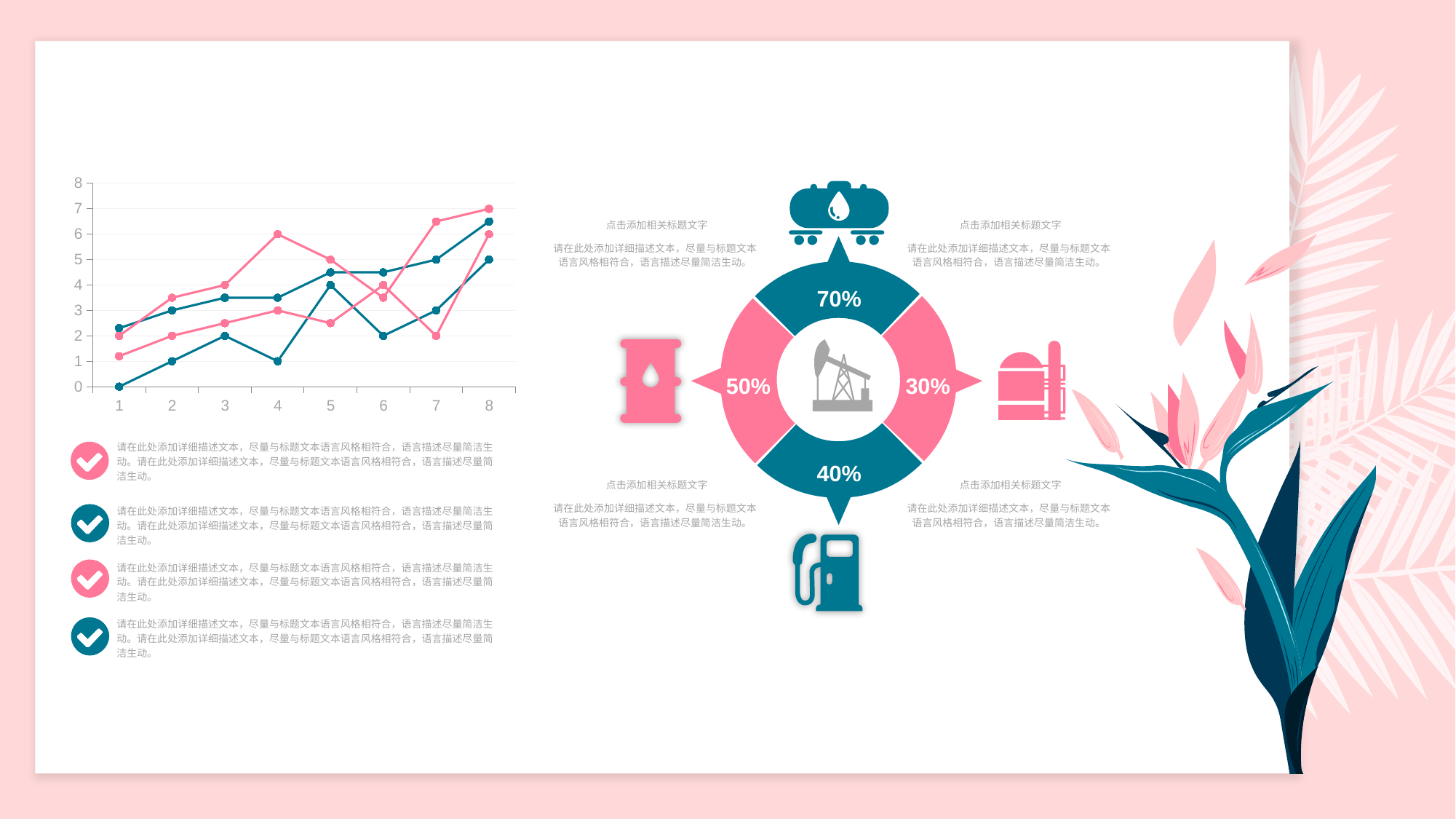
In the ring diagram on the right, what is the difference between the top segment (70%) and the right segment (30%)? 40% In the line chart on the left, what is the lowest value plotted at x = 1? 0 In the ring diagram on the right, which percentage is the largest? 70% What kind of chart is shown on the left side of the slide? line chart In the line chart on the left, how many lines are plotted? 4 In the line chart on the left, at which x position does the highest plotted value occur? 8 In the line chart on the left, what is the highest value shown on the y axis? 8 In the line chart on the left, how many points are labelled along the x axis? 8 In the line chart on the left, is the lowest value plotted at x = 8 greater or less than 4? greater In the ring diagram on the right, which percentage is the smallest? 30% In the line chart on the left, do the lines generally rise or fall from x = 1 to x = 8? rise In the line chart on the left, is the highest value plotted at x = 8 greater or less than 6? greater